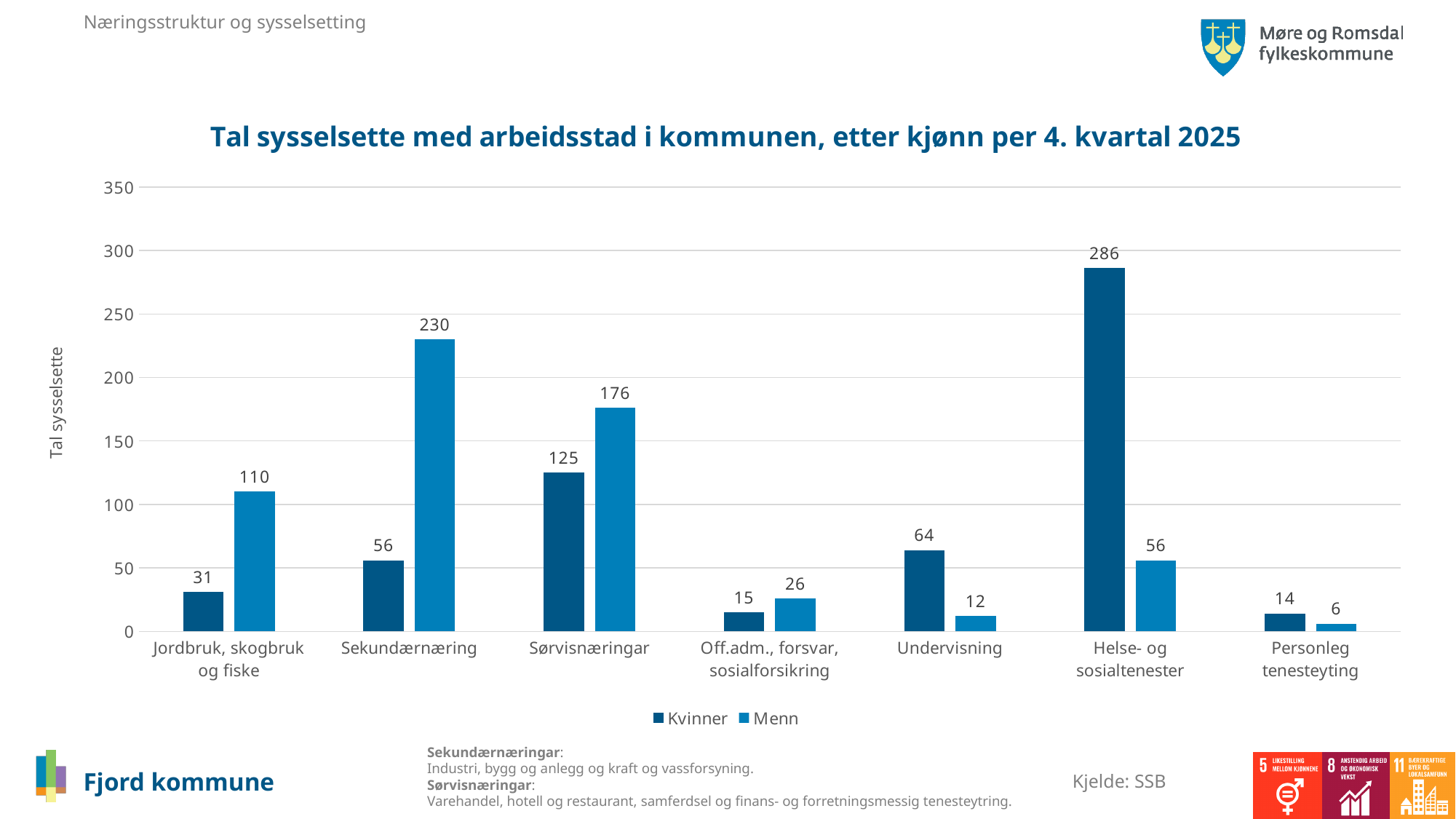
What is the difference between Menn and Kvinner in Jordbruk, skogbruk og fiske? 79 How many categories are shown on the x axis? 7 What kind of chart is shown? bar chart Which category has the lowest value for Menn? Personleg tenesteyting Which category has the highest value for Menn? Sekundærnæring Is the value for Menn in Sørvisnæringar greater or less than 150? greater What is the value for Kvinner in Helse- og sosialtenester? 286 What is the label of the y axis? Tal sysselsette What is the value for Kvinner in Sørvisnæringar? 125 What is the value for Menn in Sekundærnæring? 230 How many series does the legend list? 2 Which is larger in Undervisning, Kvinner or Menn? Kvinner